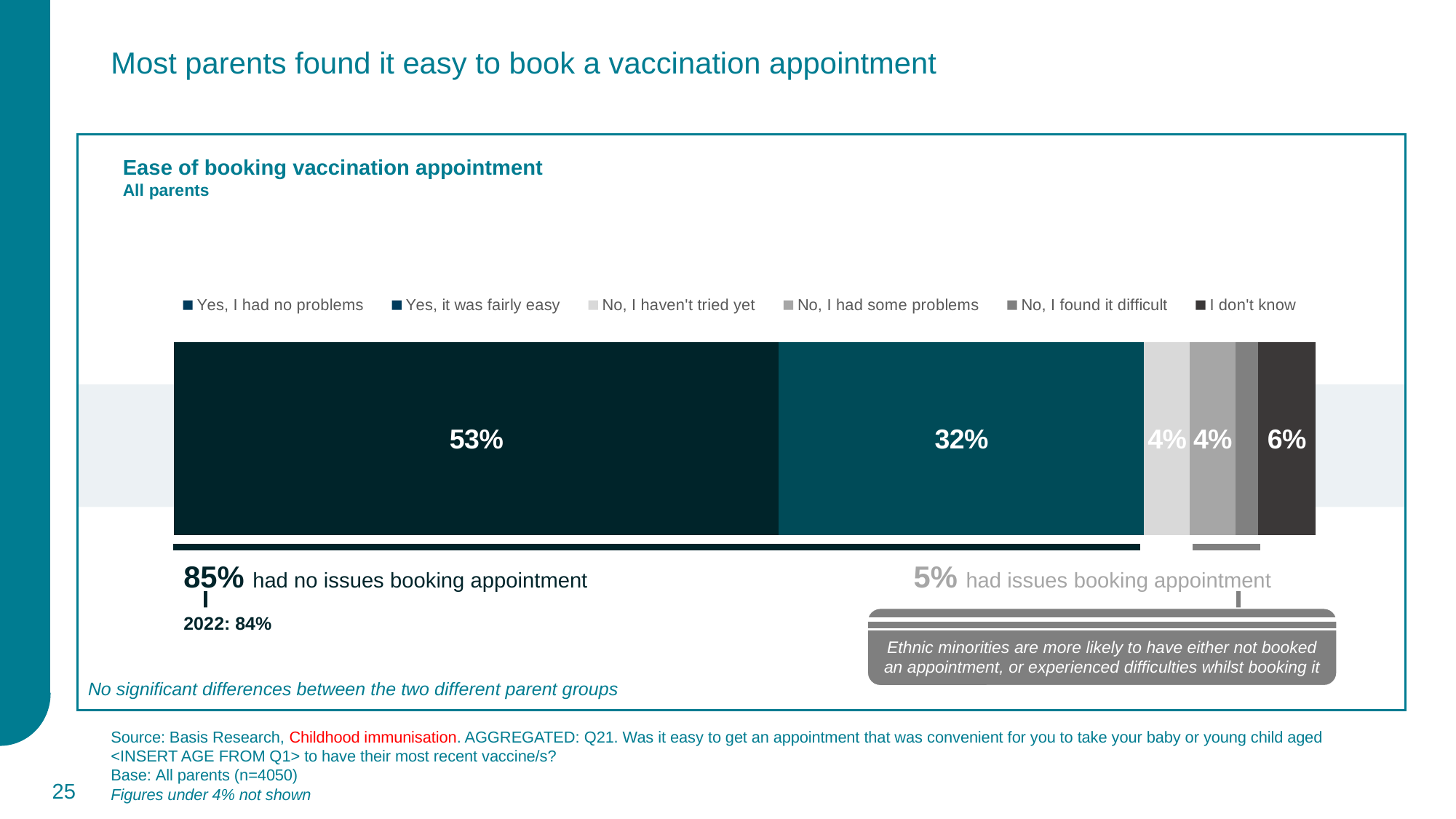
What percentage of parents said "Yes, it was fairly easy"? 32% What percentage of parents answered "I don't know"? 6% What type of chart is shown on the slide? Stacked bar chart Which group of respondents does the chart cover, according to its subtitle? All parents What percentage of parents said "No, I haven't tried yet"? 4% Which is larger: the share for "I don't know" or the share for "No, I had some problems"? I don't know What is the difference in percentage points between "Yes, I had no problems" and "Yes, it was fairly easy"? 21 percentage points What percentage of parents said "Yes, I had no problems" booking a vaccination appointment? 53% What percentage of parents said "No, I had some problems"? 4% How many response categories does the legend list? 7 Which response category has the largest share of the bar? Yes, I had no problems What is the title of the chart? Ease of booking vaccination appointment